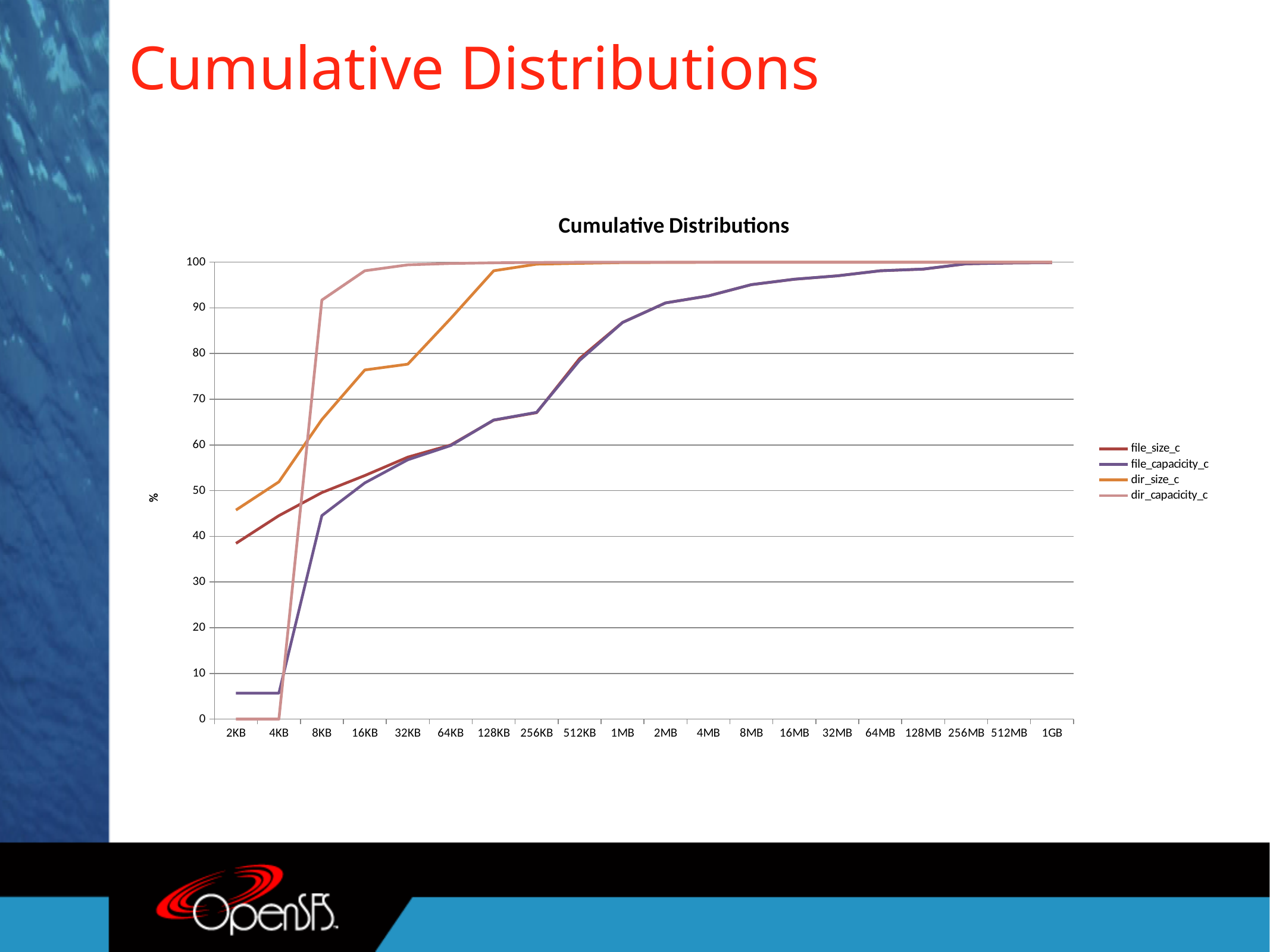
Is the value for dir_capacity_c at 8KB greater or less than 90? greater Is the value for file_capacity_c at 1MB greater or less than 80? greater What is the label on the y axis? % What kind of chart is shown on the slide? line chart At 8KB, which series has the larger value, dir_capacity_c or file_capacity_c? dir_capacity_c At 2KB, which series has the larger value, dir_size_c or file_size_c? dir_size_c How many categories are on the x axis? 20 How many series does the legend list? 4 Is the value for file_size_c at 2KB greater or less than 40? less Do the values of the file_capacity_c series rise or fall along the x axis? rise